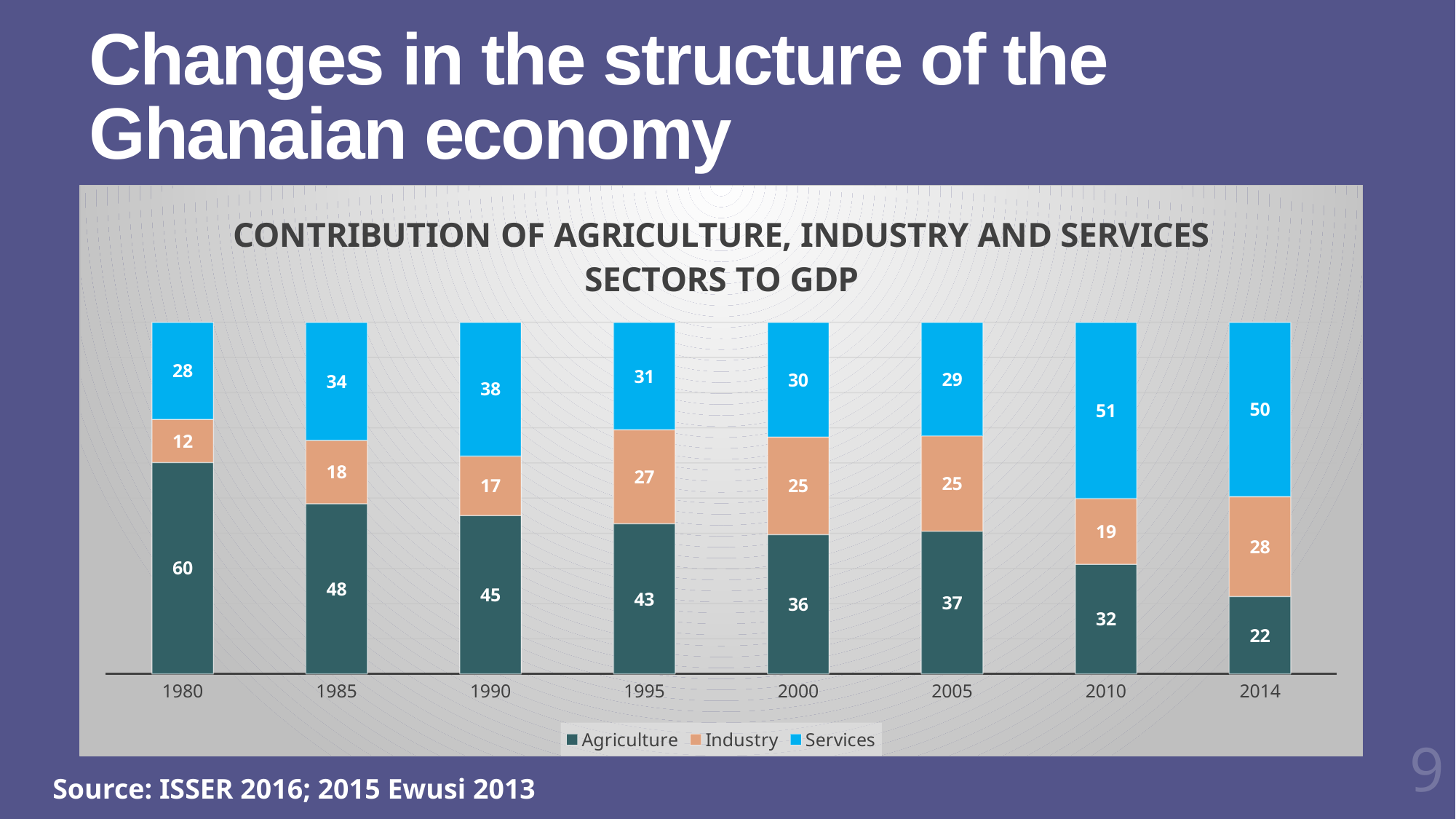
What is the Industry value for 2014? 28 What is the difference between the Agriculture values for 1980 and 2014? 38 How many series does the legend list? 3 Does the Agriculture value rise or fall from 1980 to 2014? Fall In which year is the Agriculture value highest? 1980 Which is larger, the Services value for 1990 or the Services value for 2000? 1990 What is the Industry value for 1995? 27 What kind of chart is shown? Stacked bar chart In which year is the Agriculture value lowest? 2014 What is the Agriculture value for 1980? 60 What is the Services value for 2010? 51 How many years are shown on the x axis? 8